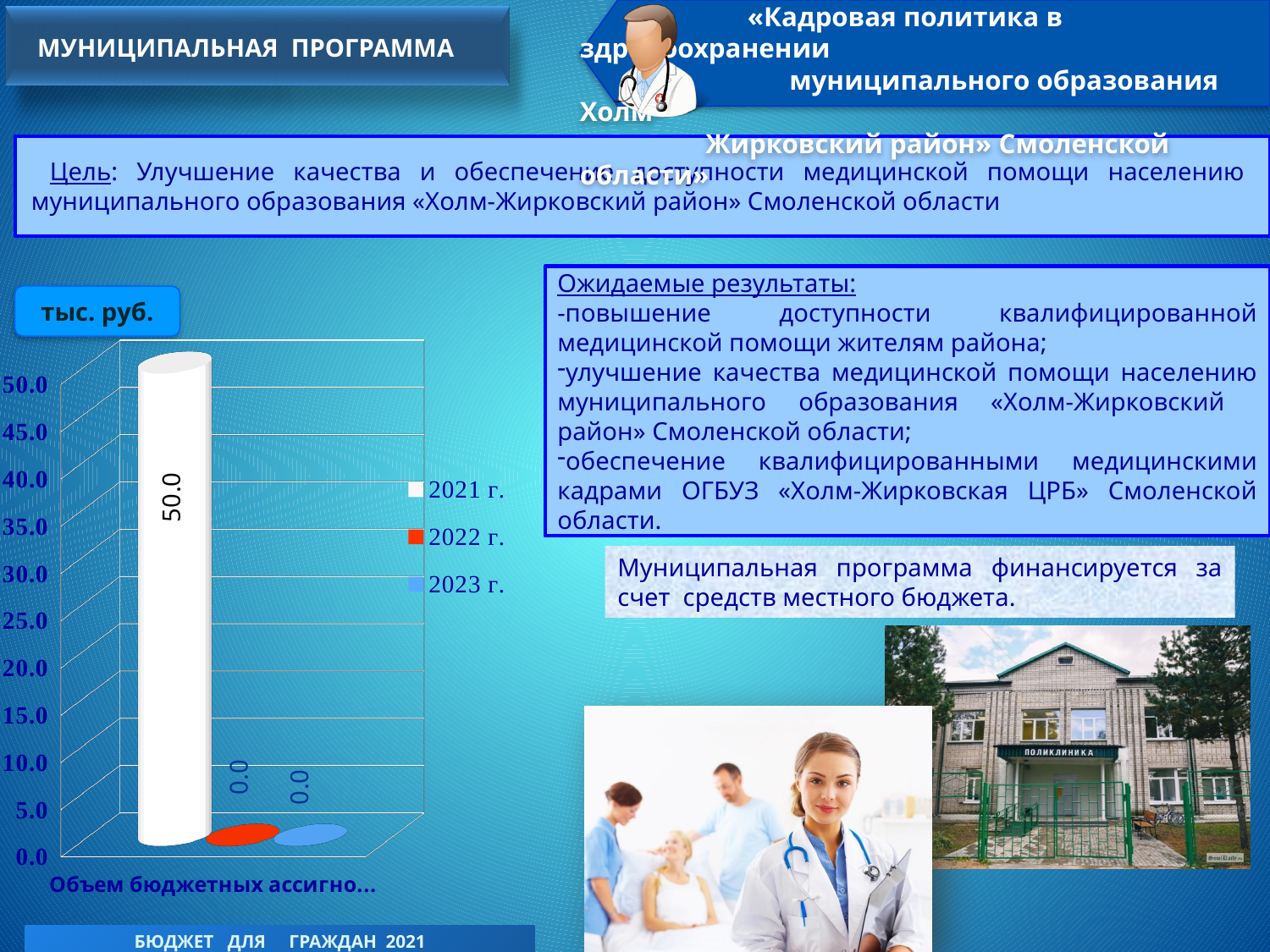
How many series does the chart legend list? 3 What kind of chart is shown on the slide? bar chart Is the value for 2021 г. greater or less than 45.0? greater Which year has the highest value in the chart? 2021 г. What unit is shown in the label above the chart? тыс. руб. Which is larger, the value for 2021 г. or the value for 2023 г.? 2021 г. What is the value for 2022 г. in the chart? 0.0 What colour is the bar for 2022 г. in the chart? red What is the value for 2023 г. in the chart? 0.0 Do the values fall or rise from 2021 г. to 2023 г.? fall What is the value for 2021 г. in the chart? 50.0 What is the difference between the values for 2021 г. and 2022 г.? 50.0